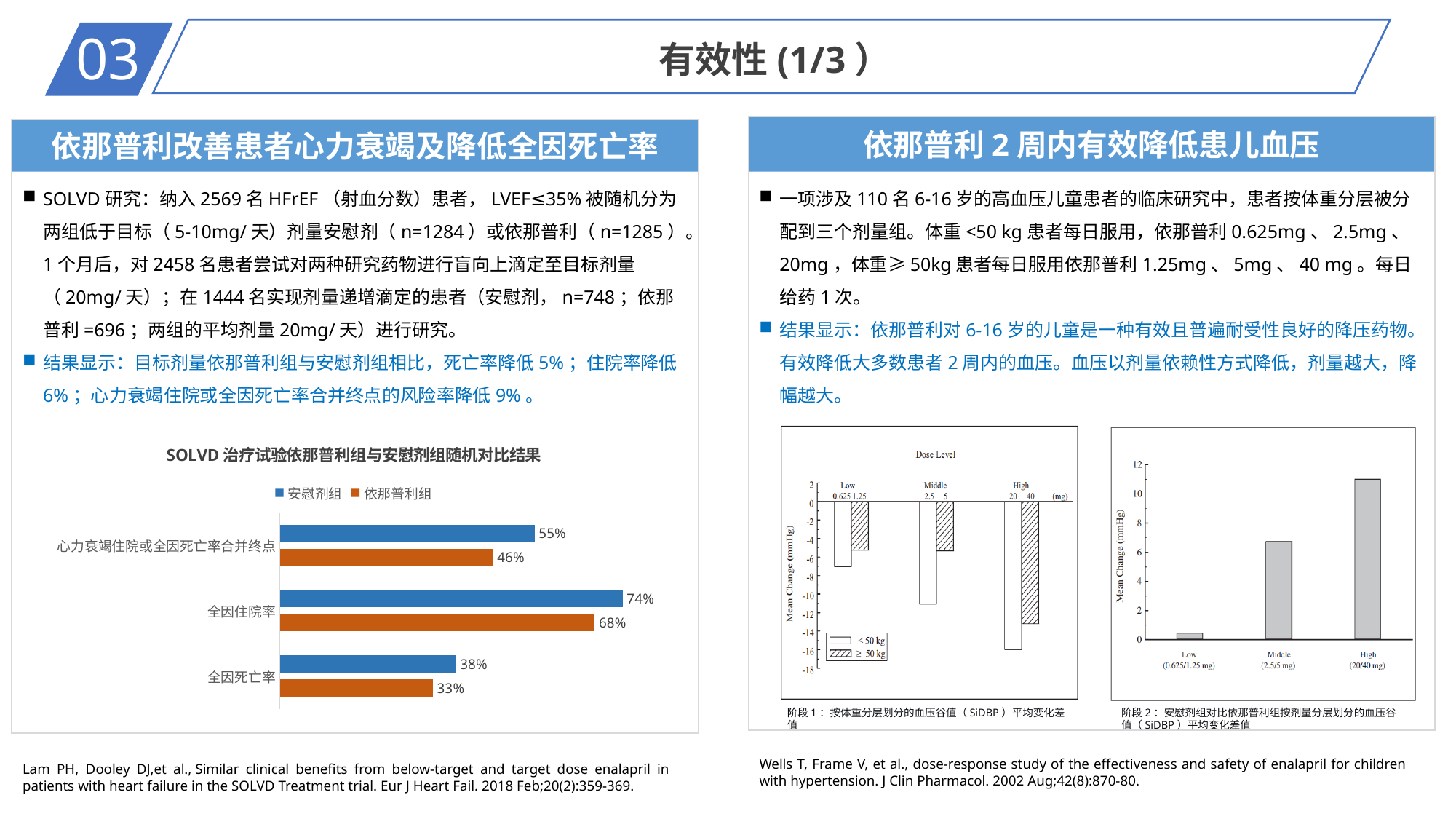
In the SOLVD chart on the left, which category has the highest value for 安慰剂组? 全因住院率 In the SOLVD chart on the left, which is larger for 全因死亡率: 安慰剂组 or 依那普利组? 安慰剂组 In the 阶段 2 chart on the right, which dose level has the highest mean change? High In the SOLVD chart on the left, what is the difference between 安慰剂组 and 依那普利组 for 全因住院率? 6% What kind of chart is the SOLVD chart on the left? Bar chart In the 阶段 2 chart on the right, is the value for the High dose level greater or less than 10? greater In the SOLVD chart on the left, what is the value for 依那普利组 for 全因死亡率? 33% In the 阶段 2 chart on the right, how many dose levels are shown? 3 In the SOLVD chart on the left, which category has the lowest value for 依那普利组? 全因死亡率 In the SOLVD chart on the left, what is the value for 安慰剂组 for 全因住院率? 74% In the SOLVD chart on the left, what is the value for 依那普利组 for 心力衰竭住院或全因死亡率合并终点? 46% In the SOLVD chart on the left, how many series does the legend list? 2